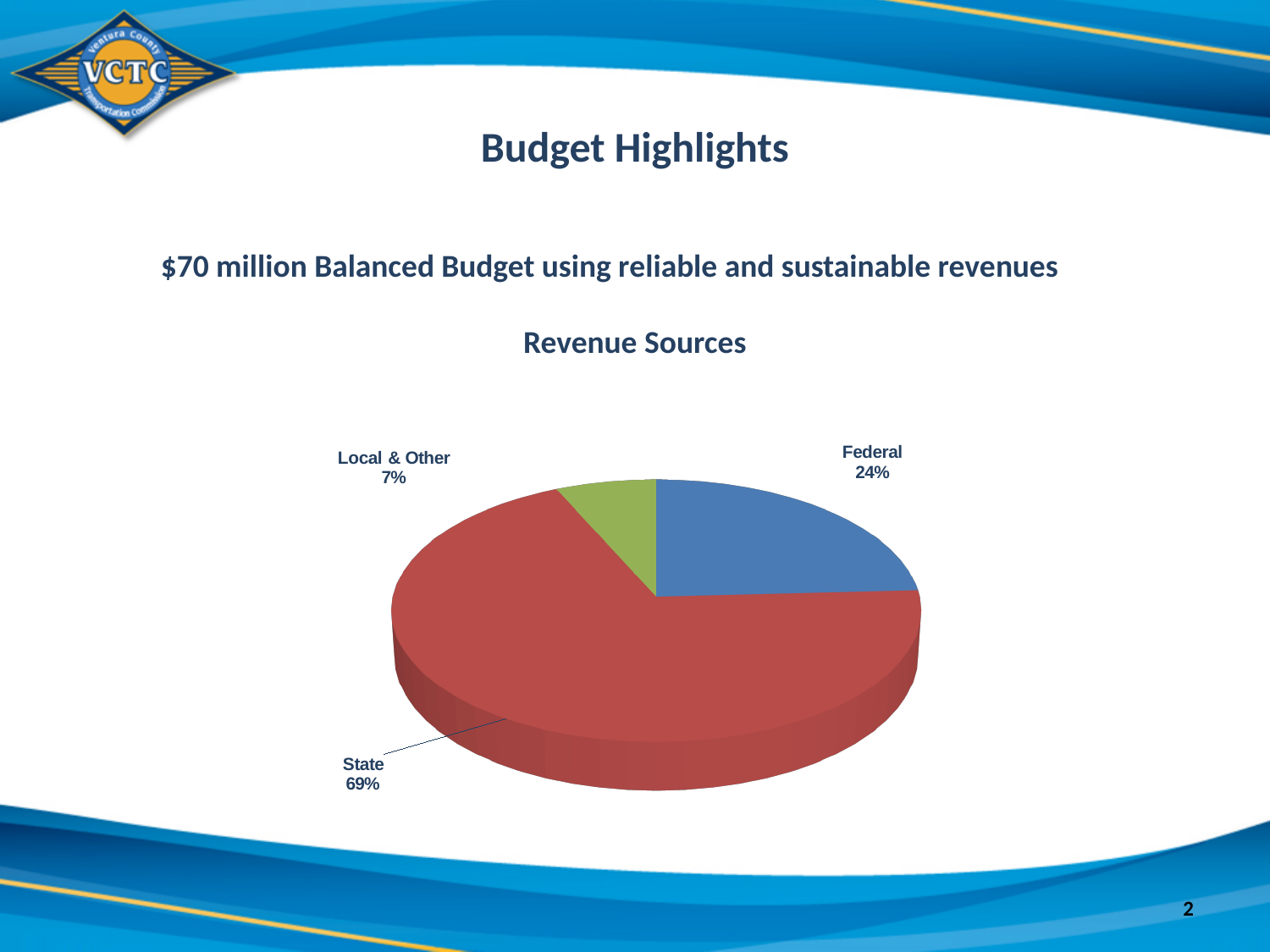
What is the title of the chart? Revenue Sources What is the difference in percentage points between the Federal and Local & Other shares? 17 Which revenue source has the smallest share of the pie? Local & Other What colour is the State slice of the pie? Red What kind of chart is shown on the slide? Pie chart How many slices does the pie chart have? 3 What share of revenue sources comes from Federal? 24% What share of revenue sources comes from State? 69% What share of revenue sources comes from Local & Other? 7% What is the difference in percentage points between the State and Federal shares? 45 Which revenue source has the largest share of the pie? State Which is larger, the Federal share or the Local & Other share? Federal